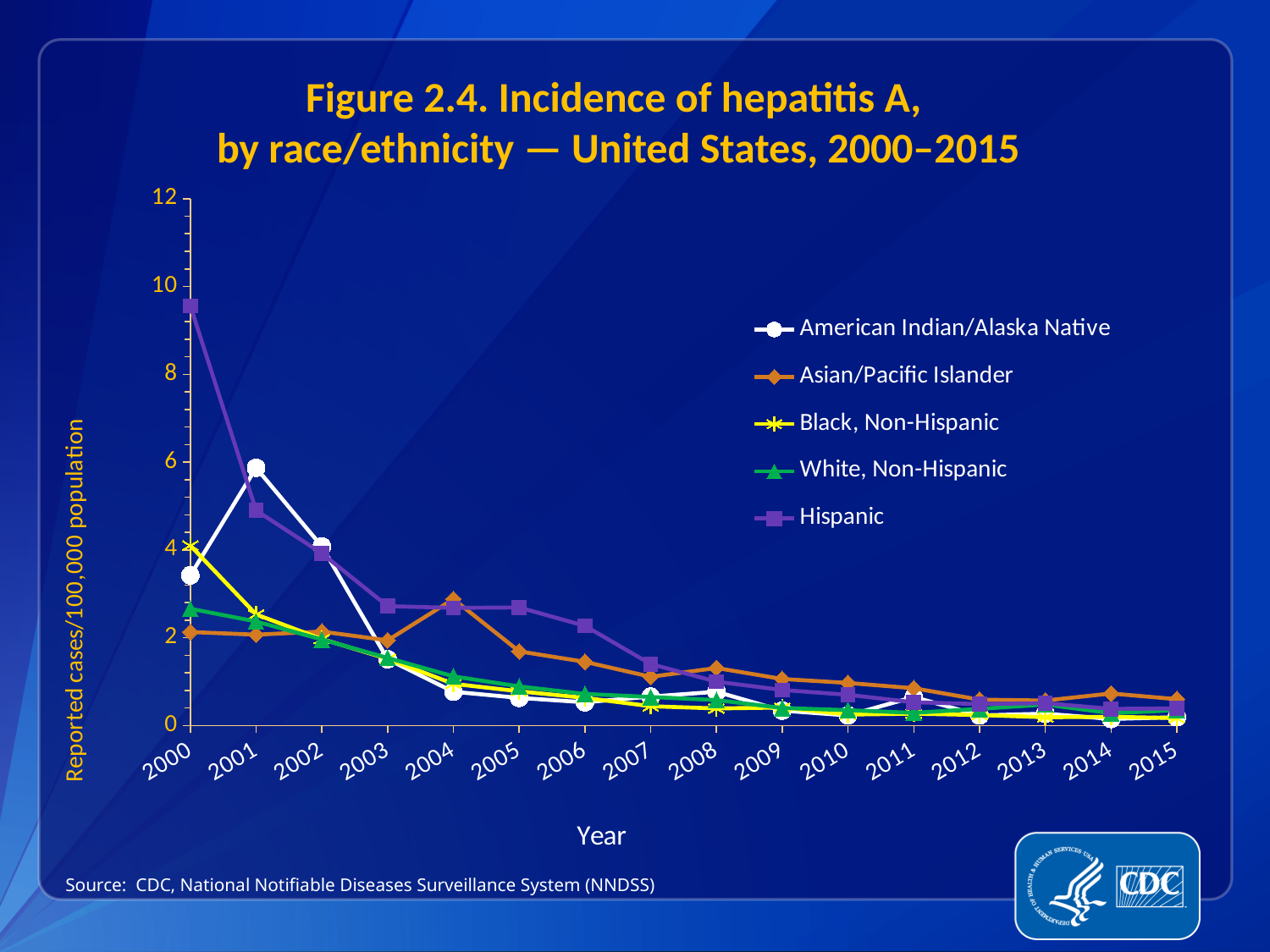
Does the incidence for Hispanic rise or fall from 2000 to 2015? fall Is the value for Hispanic in 2000 greater or less than 8? greater Which race/ethnicity group had the highest incidence in 2001? American Indian/Alaska Native What is the label on the y axis? Reported cases/100,000 population Which race/ethnicity group had the highest incidence in 2006? Hispanic Is the value for Asian/Pacific Islander in 2004 greater or less than 2? greater How many years are plotted along the x axis? 16 How many series does the legend list? 5 In 2001, which is larger: the value for American Indian/Alaska Native or the value for Hispanic? American Indian/Alaska Native What kind of chart is shown on the slide? line chart Which race/ethnicity group had the highest incidence in 2000? Hispanic Is the value for American Indian/Alaska Native in 2001 greater or less than 4? greater